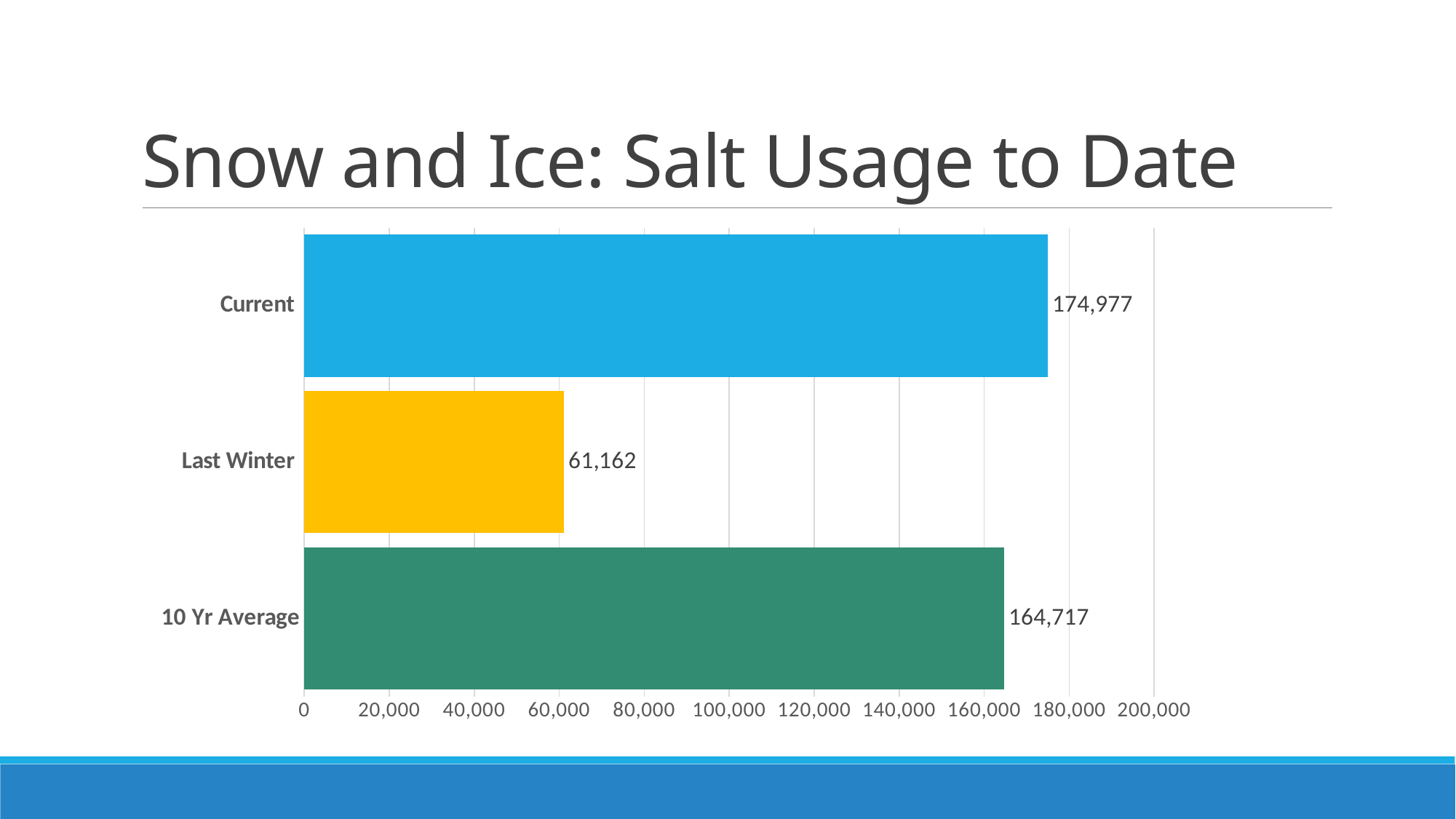
What is the salt usage value for the 10 Yr Average? 164,717 How many categories are shown in the chart? 3 What is the salt usage value for Current? 174,977 What colour is the bar for Last Winter? Yellow What is the difference between the Current value and the Last Winter value? 113,815 Is the value for Last Winter greater or less than 80,000? less Which category has the lowest salt usage? Last Winter Which is larger, the value for Last Winter or the value for the 10 Yr Average? 10 Yr Average What is the difference between the Current value and the 10 Yr Average value? 10,260 What is the salt usage value for Last Winter? 61,162 Which category has the highest salt usage? Current What kind of chart is shown on the slide? Bar chart